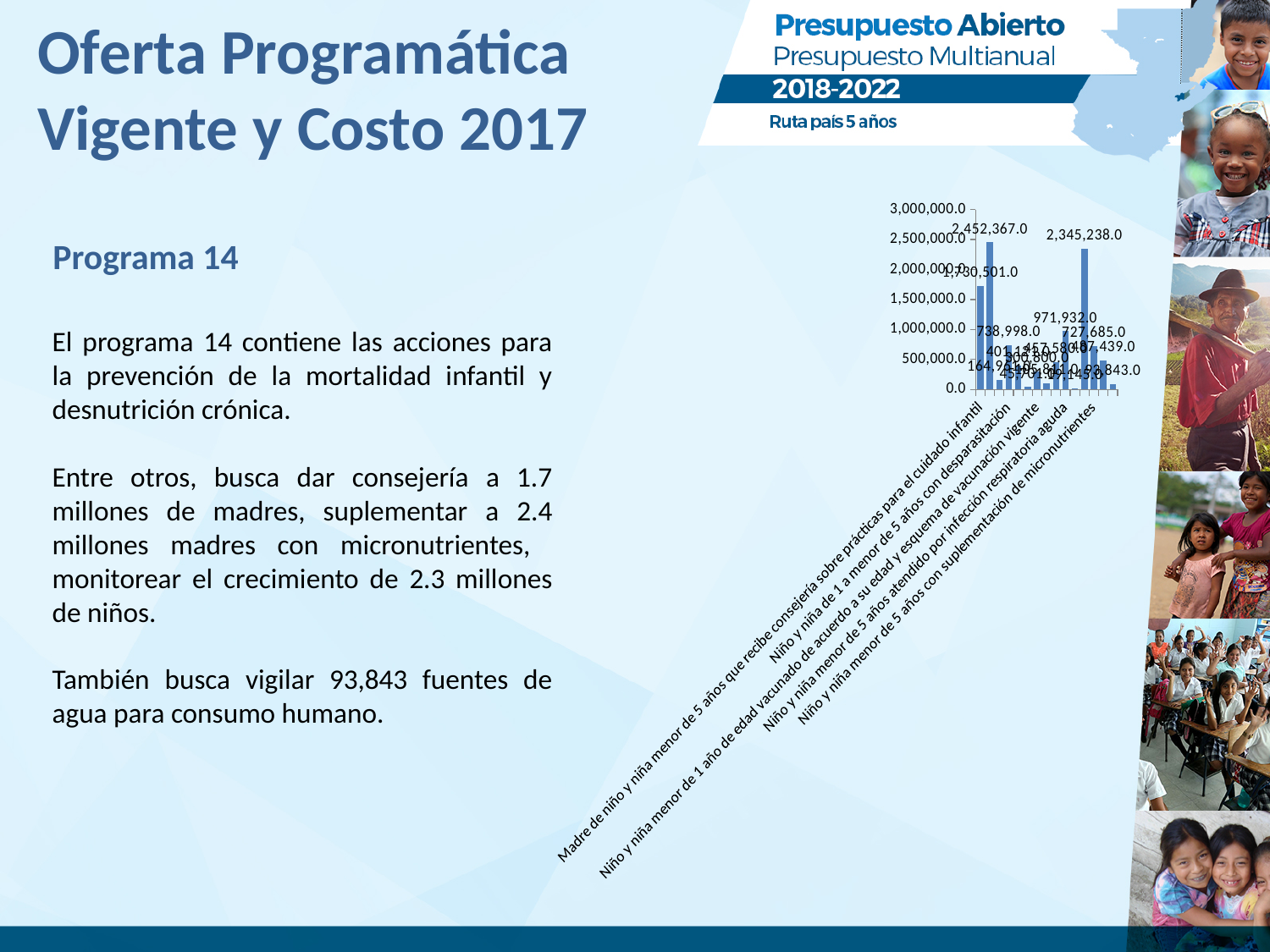
Which is larger, the bar labelled 971,932.0 or the bar labelled 738,998.0? 971,932.0 Which is larger, the bar labelled 2,452,367.0 or the bar labelled 2,345,238.0? 2,452,367.0 Is the bar labelled 1,730,501.0 greater or less than 2,000,000.0? less Is the tallest bar on the chart greater or less than 2,000,000.0? greater What is the difference between the two largest labelled values, 2,452,367.0 and 2,345,238.0? 107,129.0 Is the bar labelled 971,932.0 greater or less than 500,000.0? greater What kind of chart is shown on the slide? bar chart What is the interval between consecutive tick marks on the chart's vertical axis? 500,000.0 What is the difference between the bars labelled 738,998.0 and 727,685.0? 11,313.0 What is the highest value labelled on the chart? 2,452,367.0 What is the maximum value shown on the chart's vertical axis? 3,000,000.0